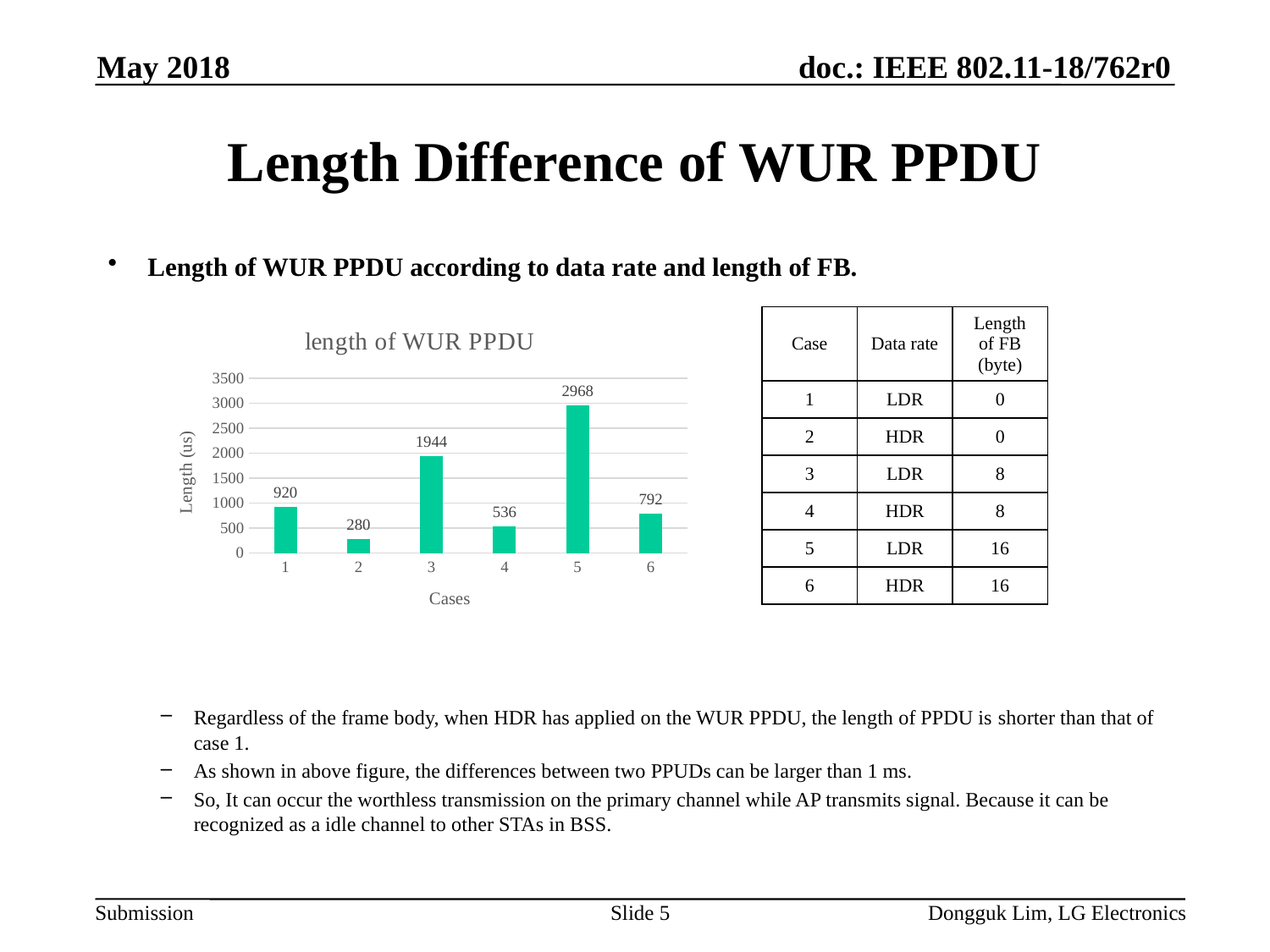
Which case has the lowest length of WUR PPDU? 2 What is the difference in length between case 5 and case 6? 2176 Which case has the highest length of WUR PPDU? 5 Is the value for case 3 greater or less than 1500? greater What is the length of WUR PPDU for case 4? 536 What is the difference in length between case 3 and case 4? 1408 What kind of chart is shown on the slide? bar chart What is the length of WUR PPDU for case 1? 920 Which has a larger length of WUR PPDU, case 1 or case 6? case 1 What is the title of the chart? length of WUR PPDU What is the length of WUR PPDU for case 5? 2968 How many cases are plotted in the chart? 6